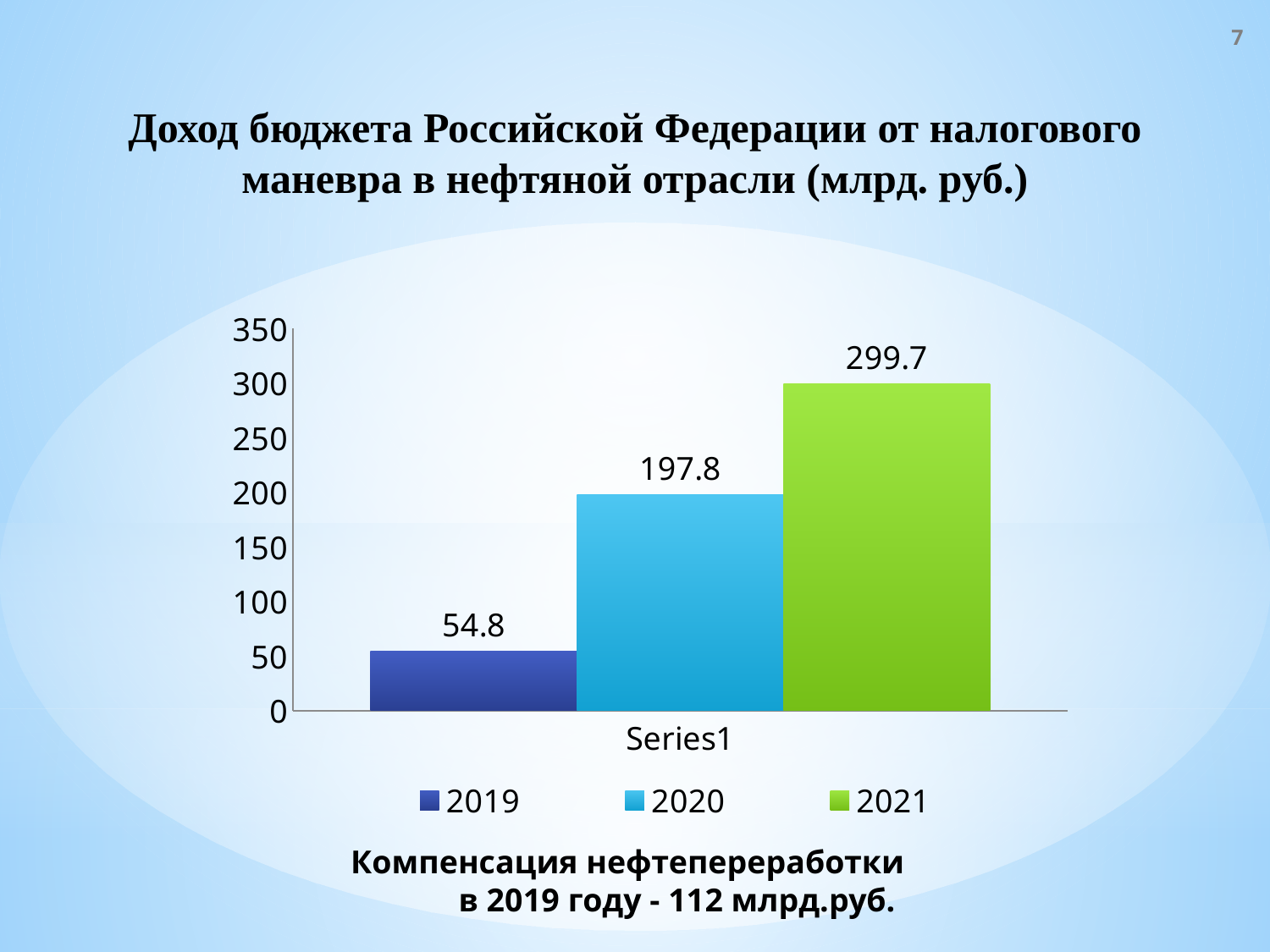
What is the value for 2019? 54.8 Which year has the lowest value? 2019 What kind of chart is shown on the slide? bar chart Is the value for 2021 greater or less than 250? greater Which year has the highest value? 2021 What is the label on the x axis under the bars? Series1 What is the difference between the values for 2021 and 2020? 101.9 Which is larger, the value for 2020 or the value for 2019? 2020 What is the value for 2020? 197.8 How many series does the legend list? 3 What is the difference between the values for 2020 and 2019? 143 What is the value for 2021? 299.7